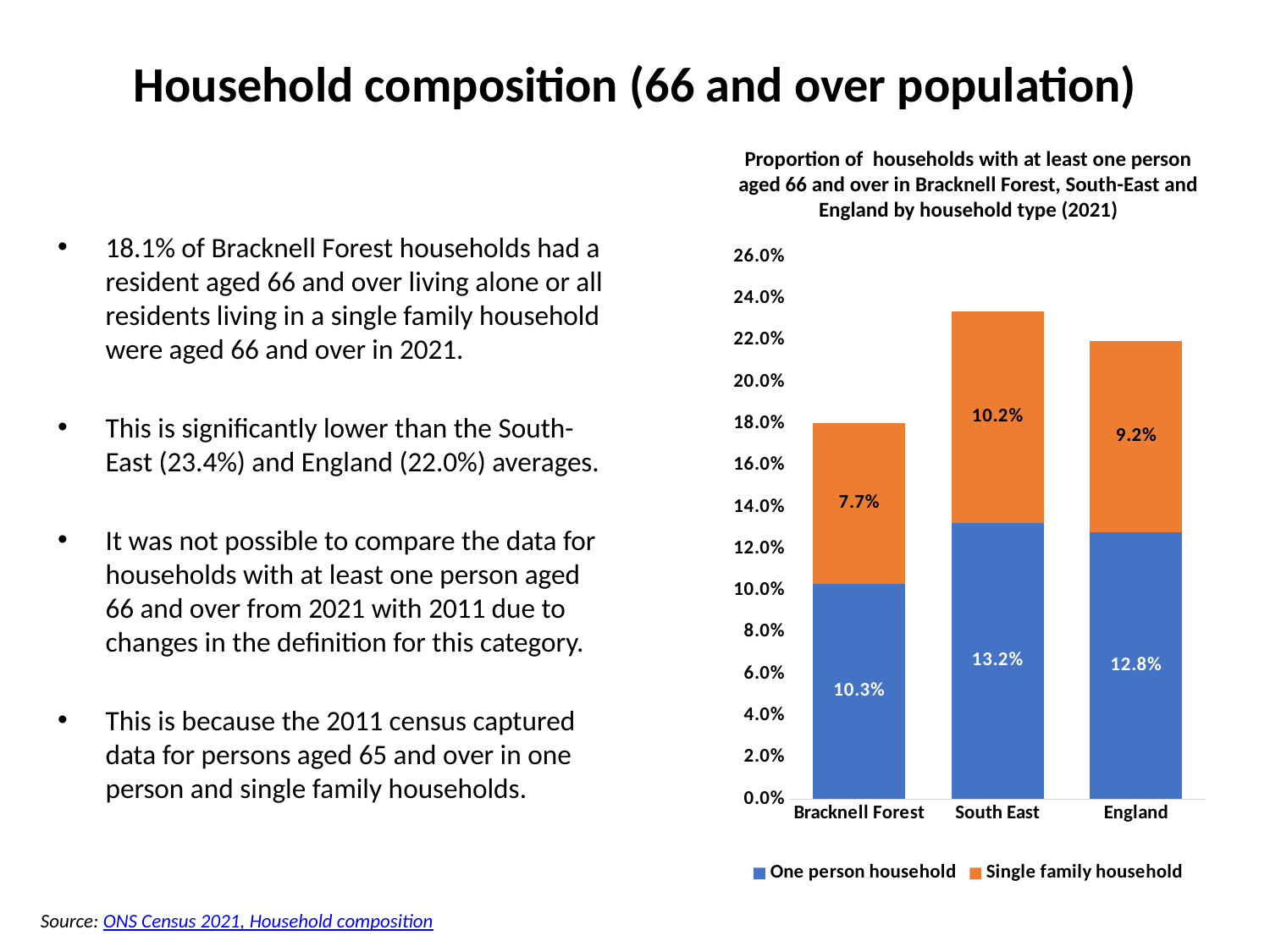
How many series does the legend list? 2 What is the value for One person household in Bracknell Forest? 10.3% What type of chart is shown on the slide? Stacked bar chart Which area has the lowest value for Single family household? Bracknell Forest What is the difference between the One person household values for South East and Bracknell Forest? 2.9% Which is larger: the Single family household value for England or for South East? South East How many areas are shown on the x axis? 3 Which area has the highest value for One person household? South East What is the value for One person household in England? 12.8% What is the value for Single family household in South East? 10.2% What is the value for Single family household in Bracknell Forest? 7.7% What is the total of the stacked bar for South East? 23.4%